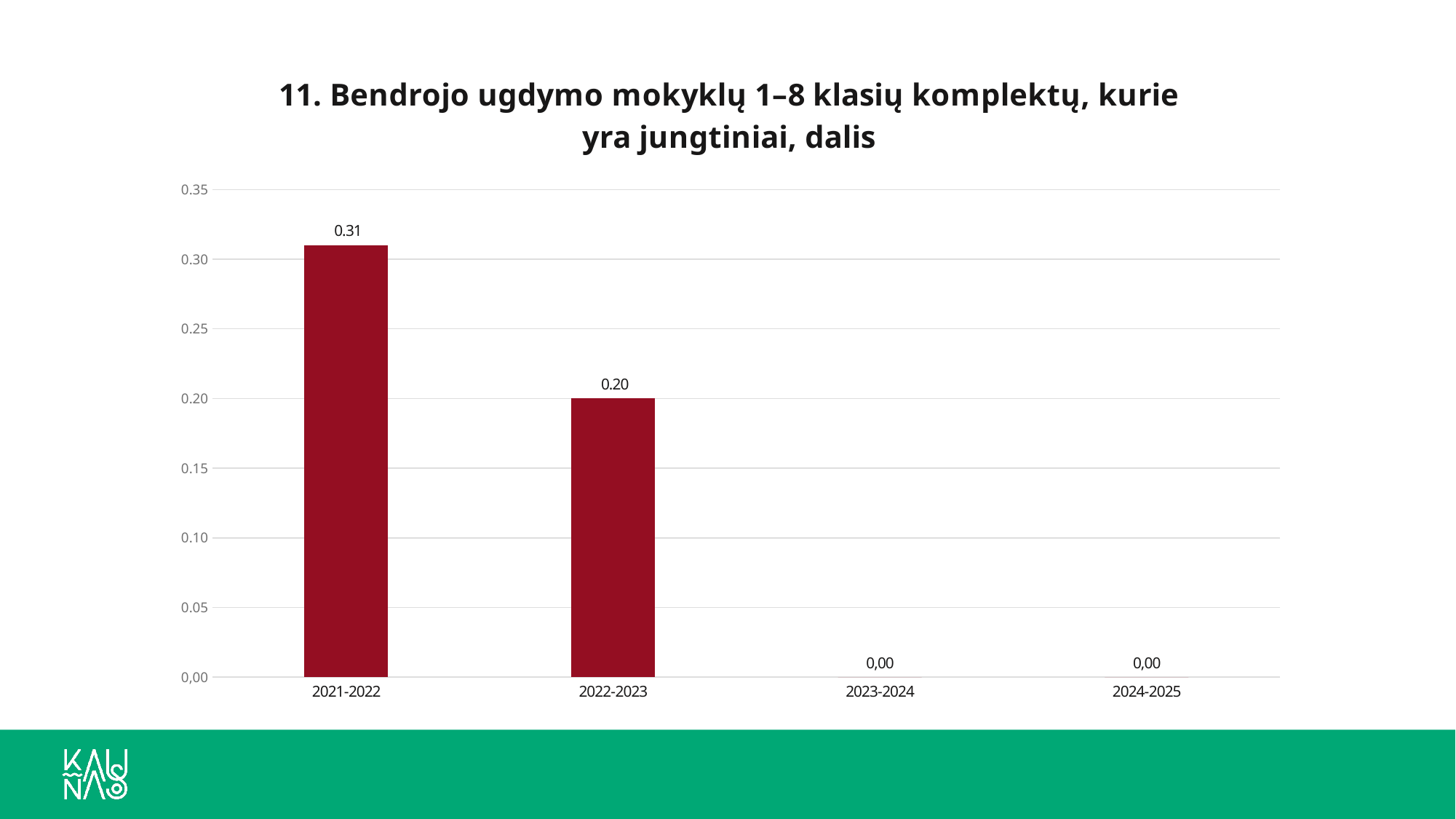
Is the value for 2021-2022 greater or less than 0.25? greater What is the value for 2021-2022? 0.31 What is the difference between the values for 2021-2022 and 2022-2023? 0.11 What is the value for 2022-2023? 0.20 What colour are the bars in the chart? dark red What is the value shown for 2024-2025? 0,00 What kind of chart is shown on the slide? bar chart Which is larger, the value for 2021-2022 or the value for 2022-2023? 2021-2022 What is the value shown for 2023-2024? 0,00 Which school year has the highest value? 2021-2022 Do the values rise or fall from 2021-2022 to 2024-2025? fall How many school years are shown on the x axis? 4